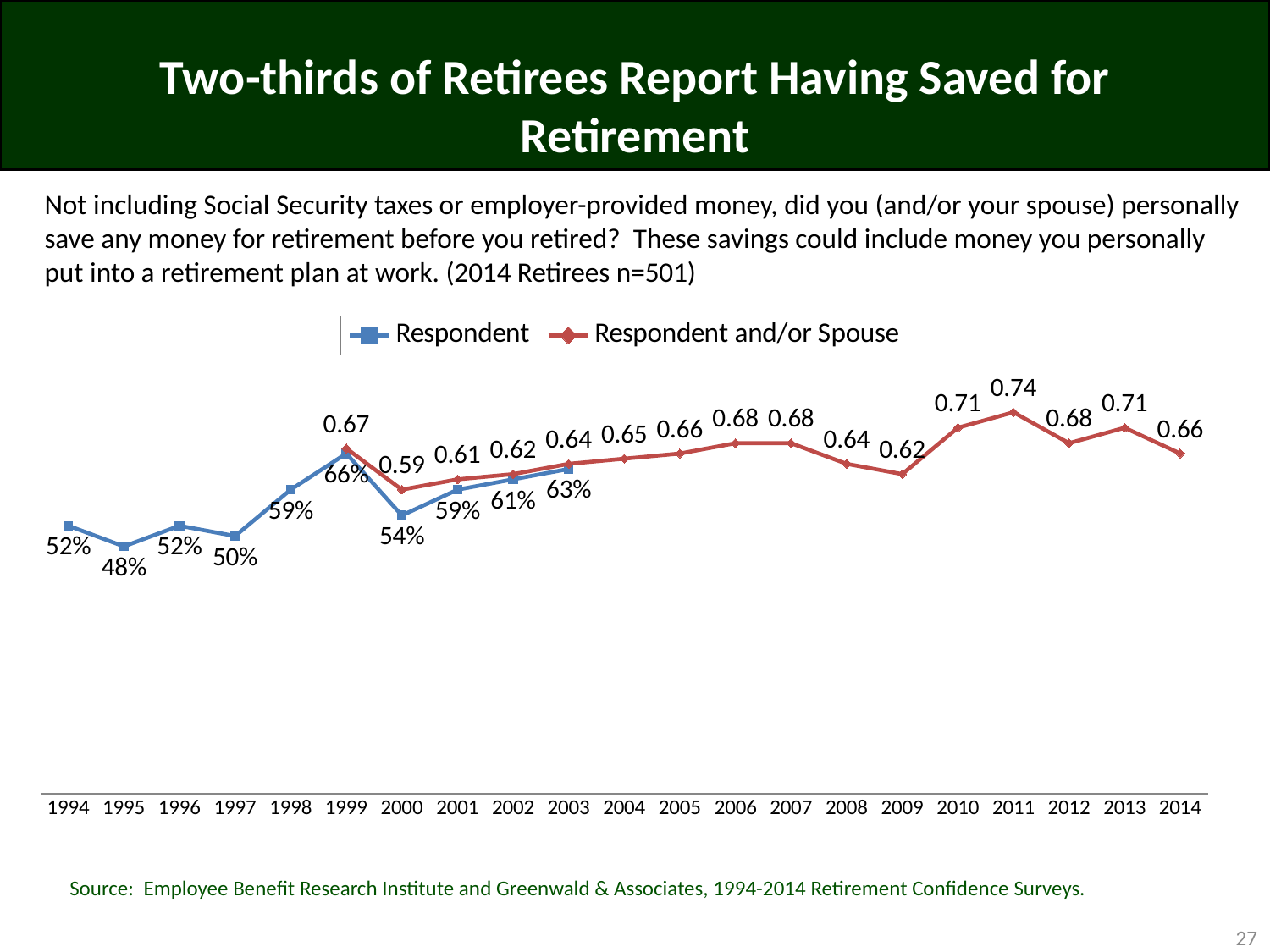
Does the Respondent series rise or fall from 2000 to 2003? Rise What is the value for Respondent in 2000? 54% What is the value for Respondent and/or Spouse in 2014? 0.66 What is the difference between the Respondent values for 1999 and 2000? 12% In which year is the Respondent and/or Spouse series highest? 2011 In which year is the Respondent series lowest? 1995 What is the value for Respondent and/or Spouse in 2011? 0.74 How many series does the legend list? 2 What kind of chart is shown on the slide? Line chart What is the value for Respondent in 1995? 48% How many years are shown on the x axis? 21 Which is larger, the Respondent and/or Spouse value for 2010 or for 2012? 2010